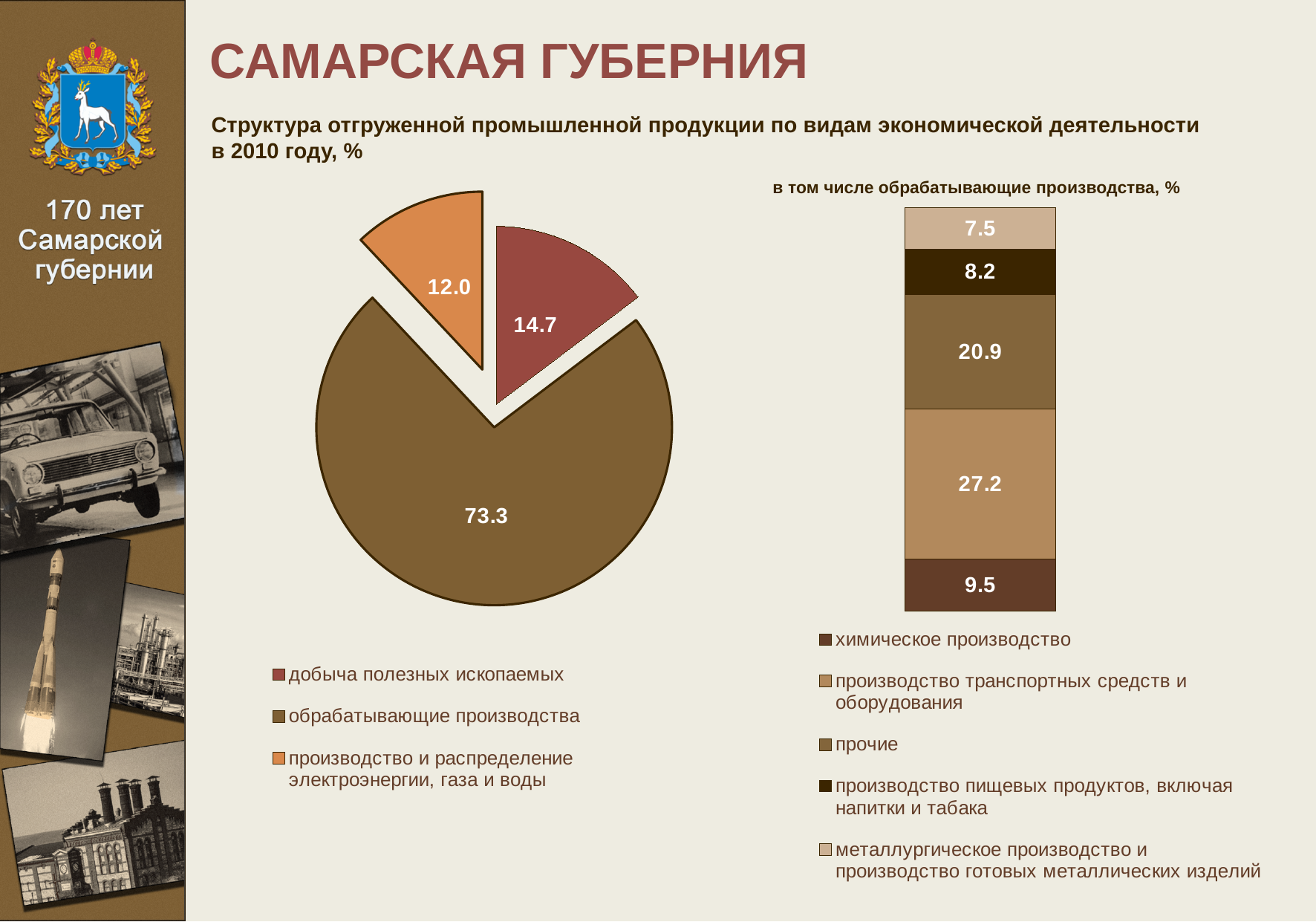
What kind of chart is the right chart (в том числе обрабатывающие производства, %)? stacked bar chart In the right stacked bar chart, which category has the lowest value? металлургическое производство и производство готовых металлических изделий In the left pie chart, what is the value for обрабатывающие производства? 73.3 In the left pie chart, what is the value for добыча полезных ископаемых? 14.7 In the right stacked bar chart, what is the value for производство транспортных средств и оборудования? 27.2 In the right stacked bar chart, what is the total of all segments? 73.3 How many categories does the legend of the left pie chart list? 3 In the right stacked bar chart, which is larger: прочие or производство пищевых продуктов, включая напитки и табака? прочие In the left pie chart, which category has the smallest slice? производство и распределение электроэнергии, газа и воды In the right stacked bar chart, what is the value for химическое производство? 9.5 In the left pie chart, what is the difference between the values for добыча полезных ископаемых and производство и распределение электроэнергии, газа и воды? 2.7 What kind of chart is the left chart on the slide? pie chart